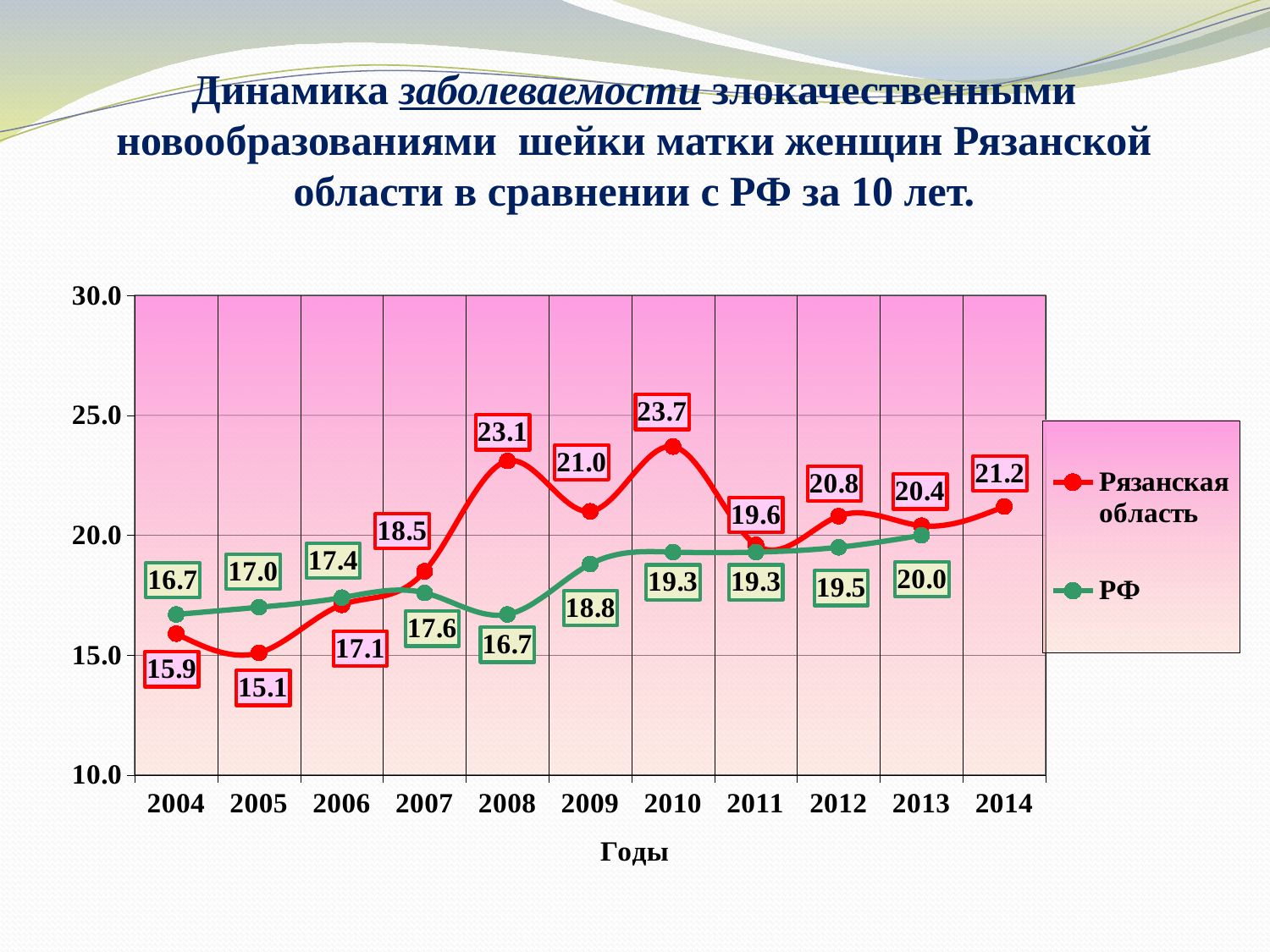
What type of chart is shown on the slide? line chart What is the difference between Рязанская область and РФ in 2008? 6.4 Which series has the larger value in 2004, Рязанская область or РФ? РФ In which year is the value for Рязанская область highest? 2010 What is the value for РФ in 2009? 18.8 What is the value for Рязанская область in 2005? 15.1 How many years are shown on the x axis? 11 What is the value for Рязанская область in 2010? 23.7 Does the value for РФ generally rise or fall from 2004 to 2013? rise What label is shown on the x axis? Годы How many series does the legend list? 2 In which year is the value for Рязанская область lowest? 2005